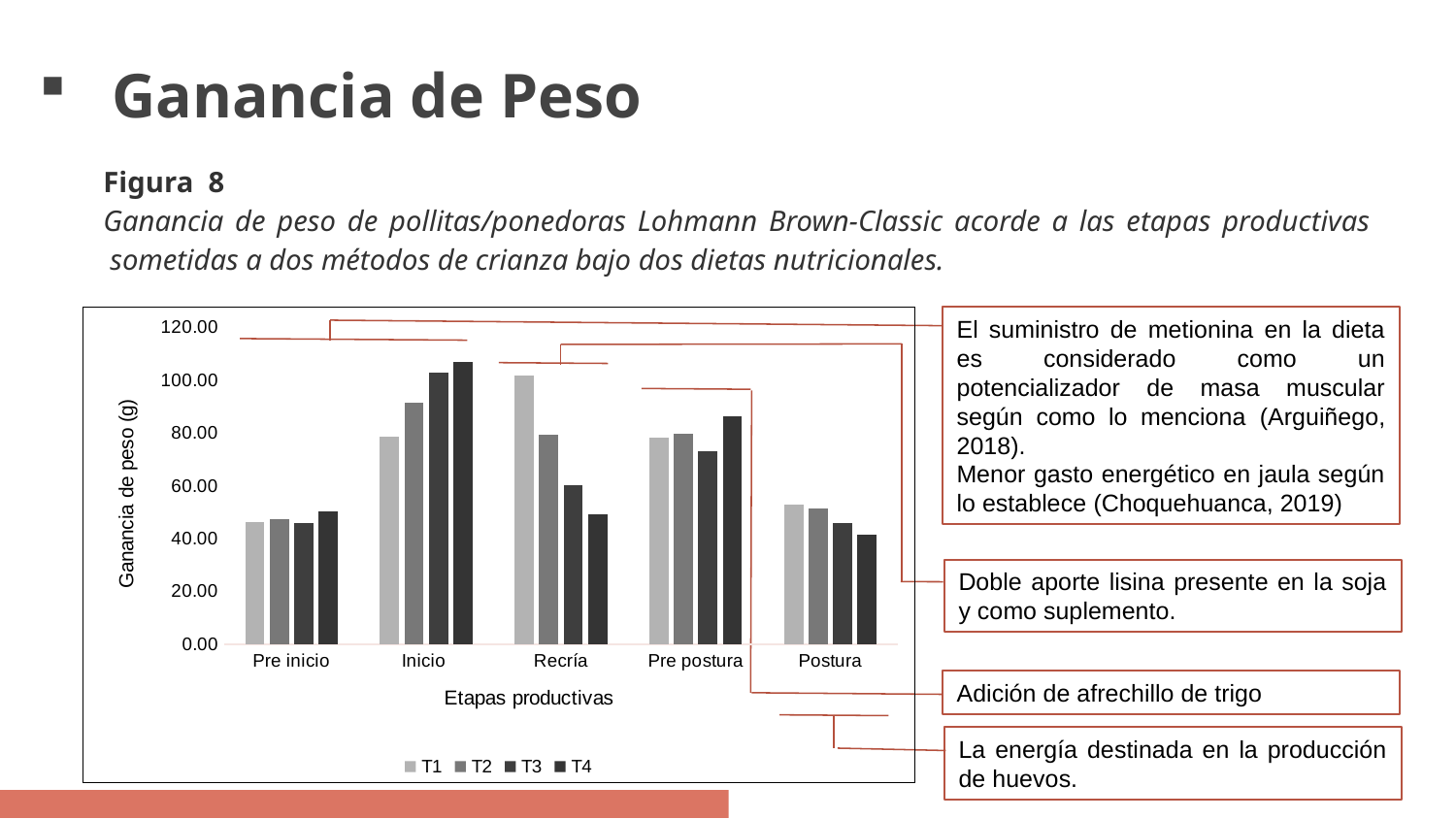
What kind of chart is shown on the slide? bar chart Which series has the lowest value in the Inicio stage? T1 Is the value for T1 in the Pre inicio stage greater or less than 40? greater Is the value for T4 in the Postura stage greater or less than 60? less How many productive stages (categories) are shown on the x axis of the chart? 5 In the Pre postura stage, which is larger, the value for T4 or the value for T3? T4 Which series has the highest value in the Recría stage? T1 What is the label of the horizontal axis of the chart? Etapas productivas What is the label of the vertical axis of the chart? Ganancia de peso (g) Is the value for T4 in the Inicio stage greater or less than 100? greater How many series does the chart legend list? 4